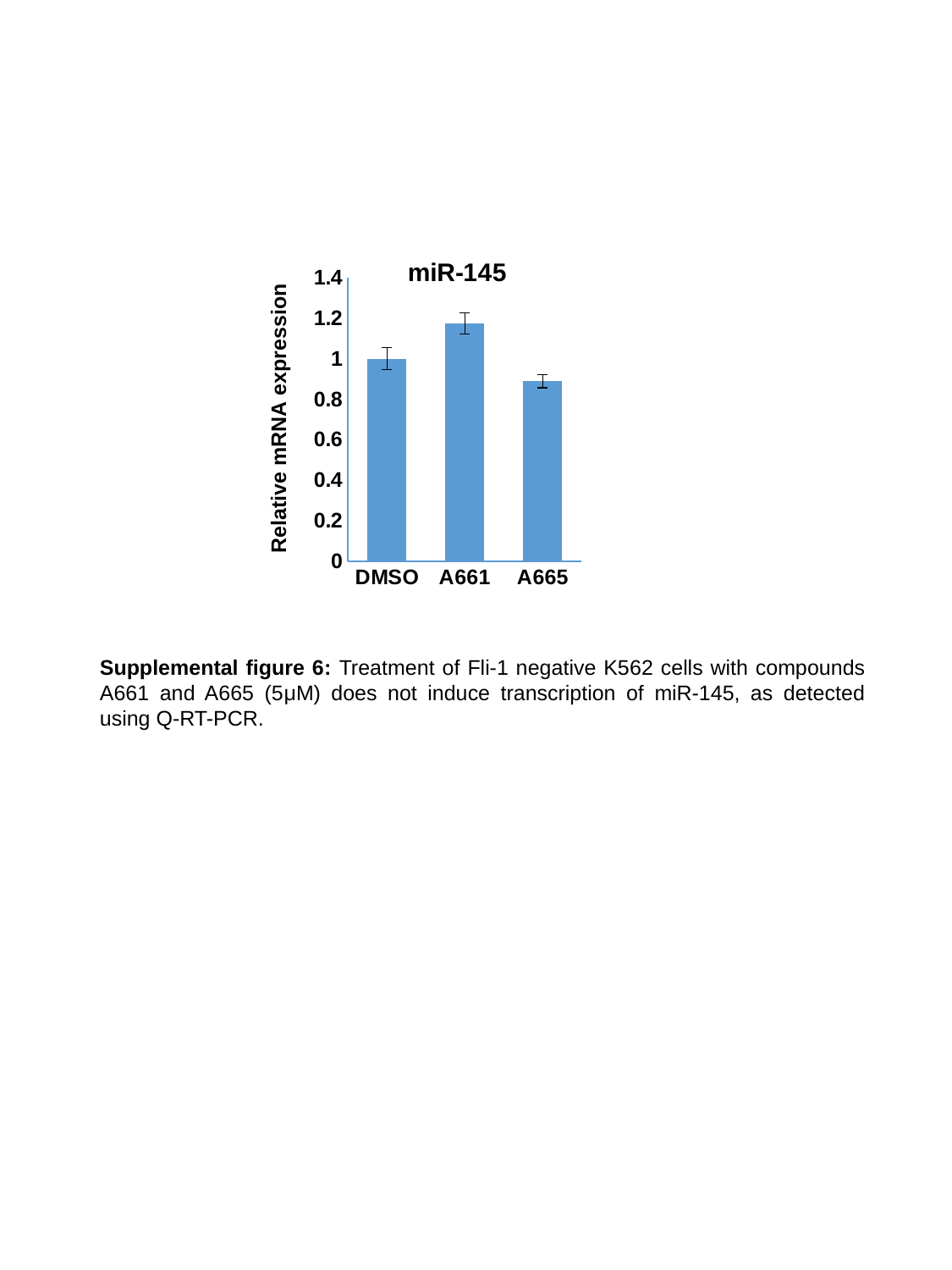
What is the label of the y axis? Relative mRNA expression Does the value rise or fall from A661 to A665? fall Is the value for A665 greater or less than 0.8? greater Is the value for A661 greater or less than 1? greater Is the value for A665 greater or less than 1? less What is the title of the chart? miR-145 How many categories are plotted on the x axis? 3 Which has the larger relative mRNA expression, A661 or A665? A661 What is the relative mRNA expression value for DMSO? 1 Which category has the highest relative mRNA expression? A661 What kind of chart is shown on the slide? bar chart Which category has the lowest relative mRNA expression? A665